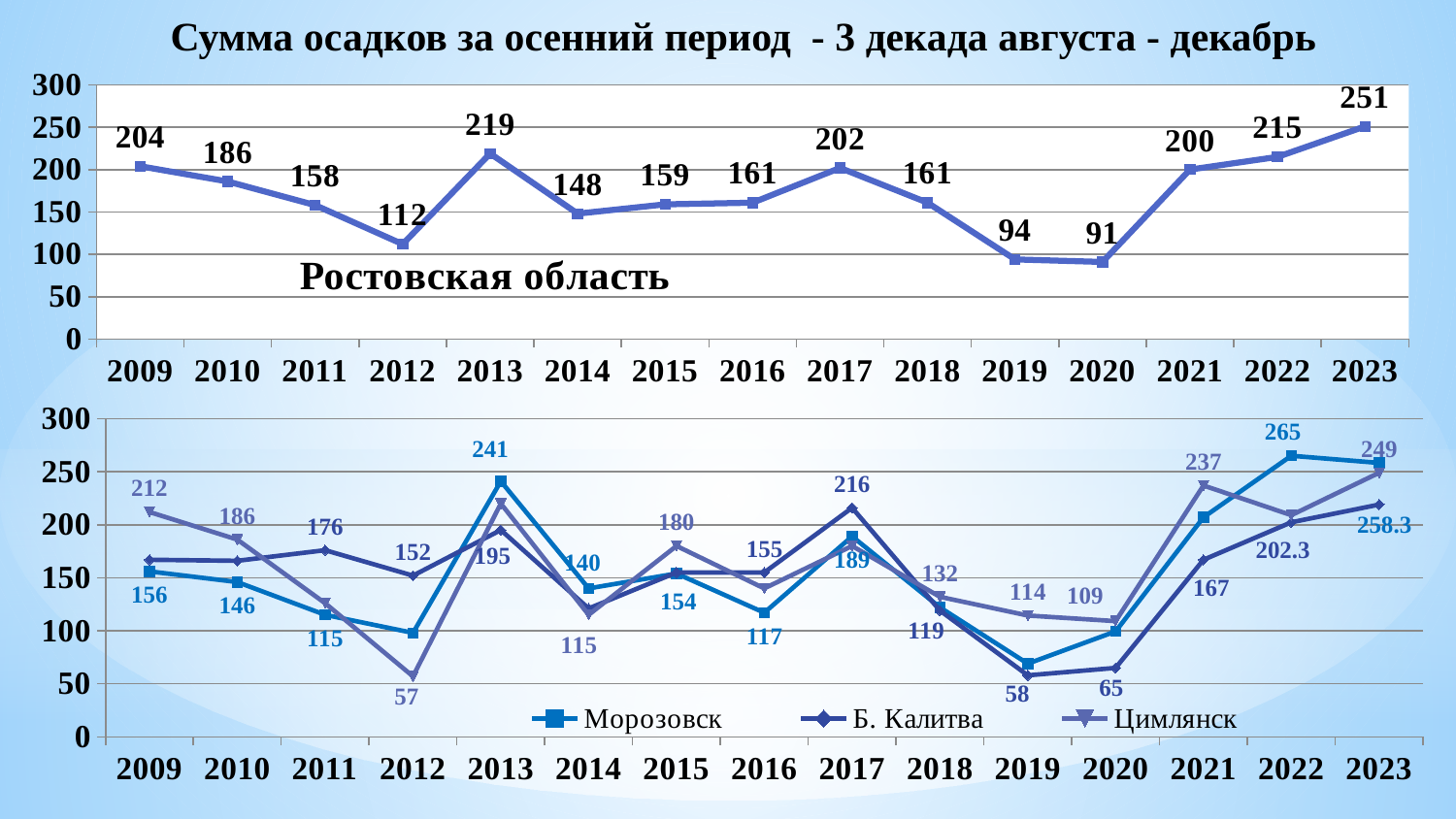
In the top chart (Ростовская область), which year has the lowest value? 2020 In the bottom chart, what is the value for Цимлянск in 2012? 57 In the top chart (Ростовская область), which year has the larger value, 2017 or 2018? 2017 In the top chart (Ростовская область), which year has the highest value? 2023 In the top chart (Ростовская область), what is the value for 2013? 219 In the top chart (Ростовская область), what is the difference between the values for 2023 and 2009? 47 In the top chart (Ростовская область), how many years are plotted on the x axis? 15 In the top chart (Ростовская область), what is the value for 2020? 91 What kind of chart is the top chart (Ростовская область)? line chart In the bottom chart, how many series does the legend list? 3 In the bottom chart, what is the value for Морозовск in 2022? 265 In the top chart (Ростовская область), do the values rise or fall from 2009 to 2012? fall